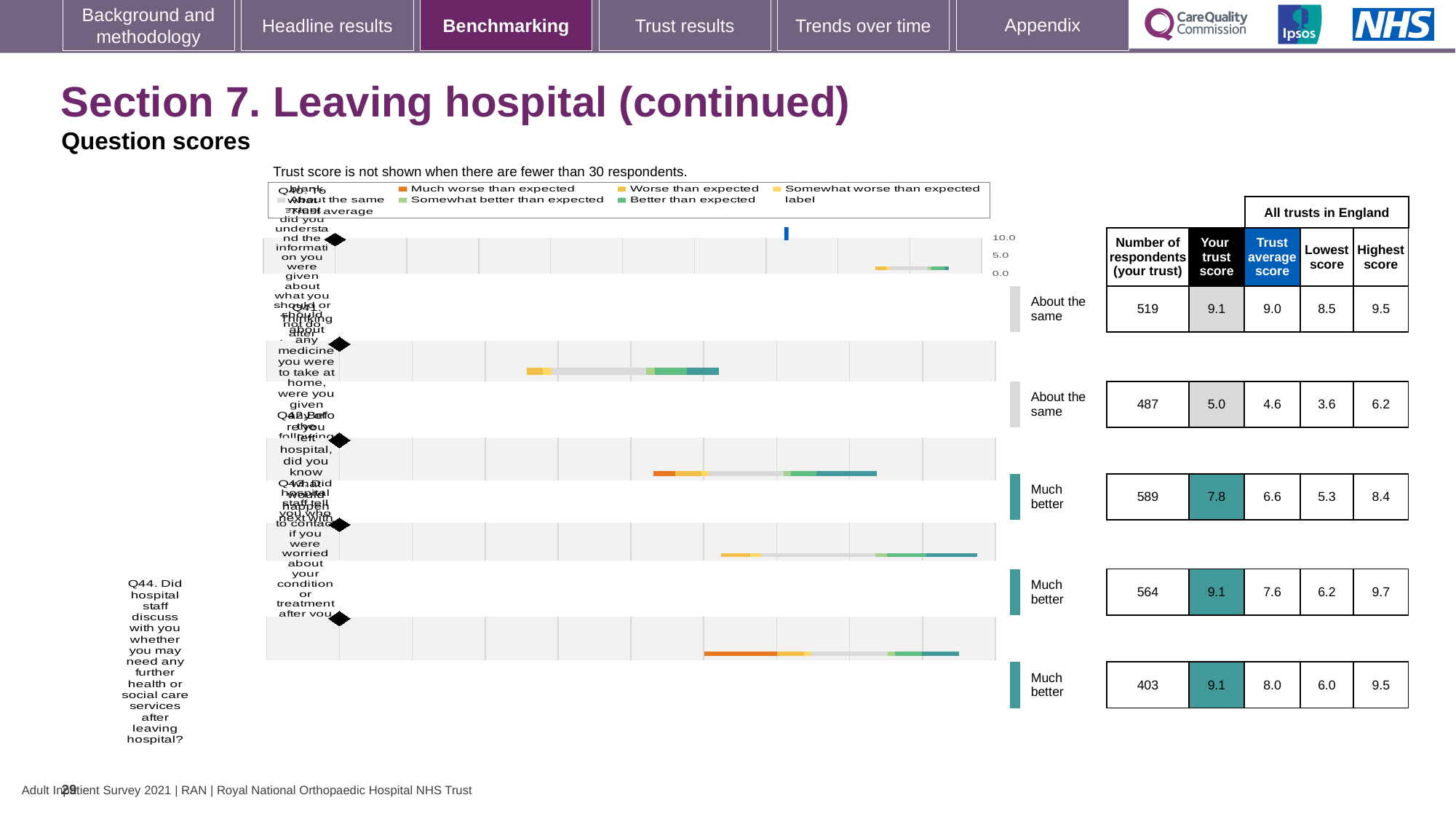
Which row has the highest number of respondents? the third row (Q42), 589 What is the number of respondents for Q44 (the last row), about whether hospital staff discussed the need for further health or social care services after leaving hospital? 403 What is the lowest score across all trusts in England for the second row (Q41)? 3.6 What is the trust score for Q44 (the last row)? 9.1 Which row has the lowest trust score? the second row (Q41), 5.0 How many questions (rows) are plotted in the benchmarking chart? 5 What is the trust average score for Q44 (the last row)? 8.0 How many rows are rated 'Much better' than expected? 3 What is the difference between the trust score and the trust average score for the third row (Q42)? 1.2 What is the highest score across all trusts in England for the fourth row (Q43)? 9.7 Is the trust score for the fourth row (Q43) larger or smaller than the trust average score? larger What kind of chart is used to show the question scores on this slide? bar chart